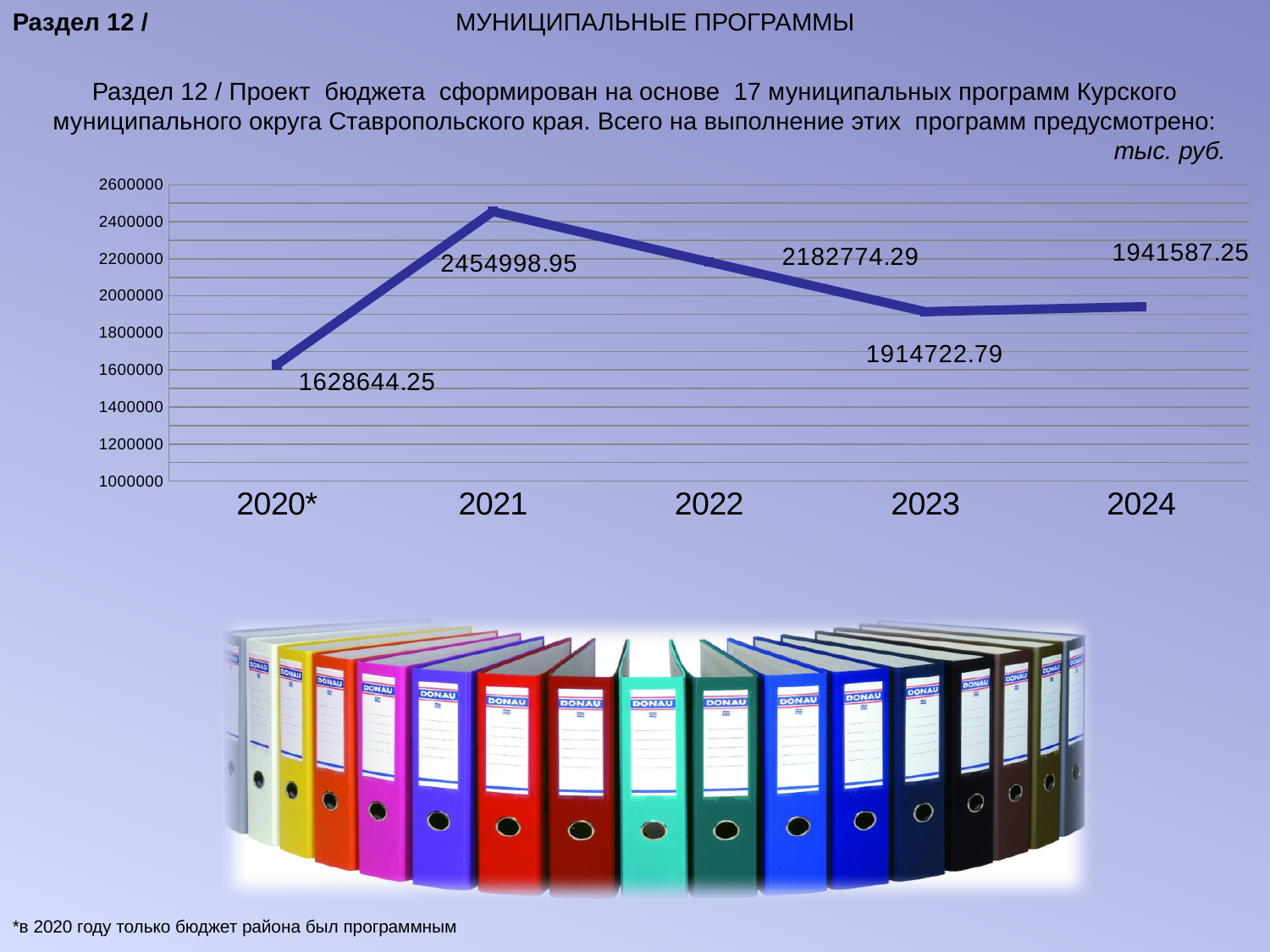
What is the value for 2021 on the chart? 2454998.95 How many years are plotted on the chart? 5 What is the value for 2020* on the chart? 1628644.25 What kind of chart is shown on the slide? line chart Which year has the lowest value on the chart? 2020* What is the value for 2023 on the chart? 1914722.79 Which is larger, the value for 2022 or the value for 2023? 2022 What is the difference between the values for 2021 and 2022? 272224.66 What is the difference between the values for 2024 and 2023? 26864.46 Which year has the highest value on the chart? 2021 Is the value for 2022 greater or less than 2000000? greater What is the value for 2024 on the chart? 1941587.25